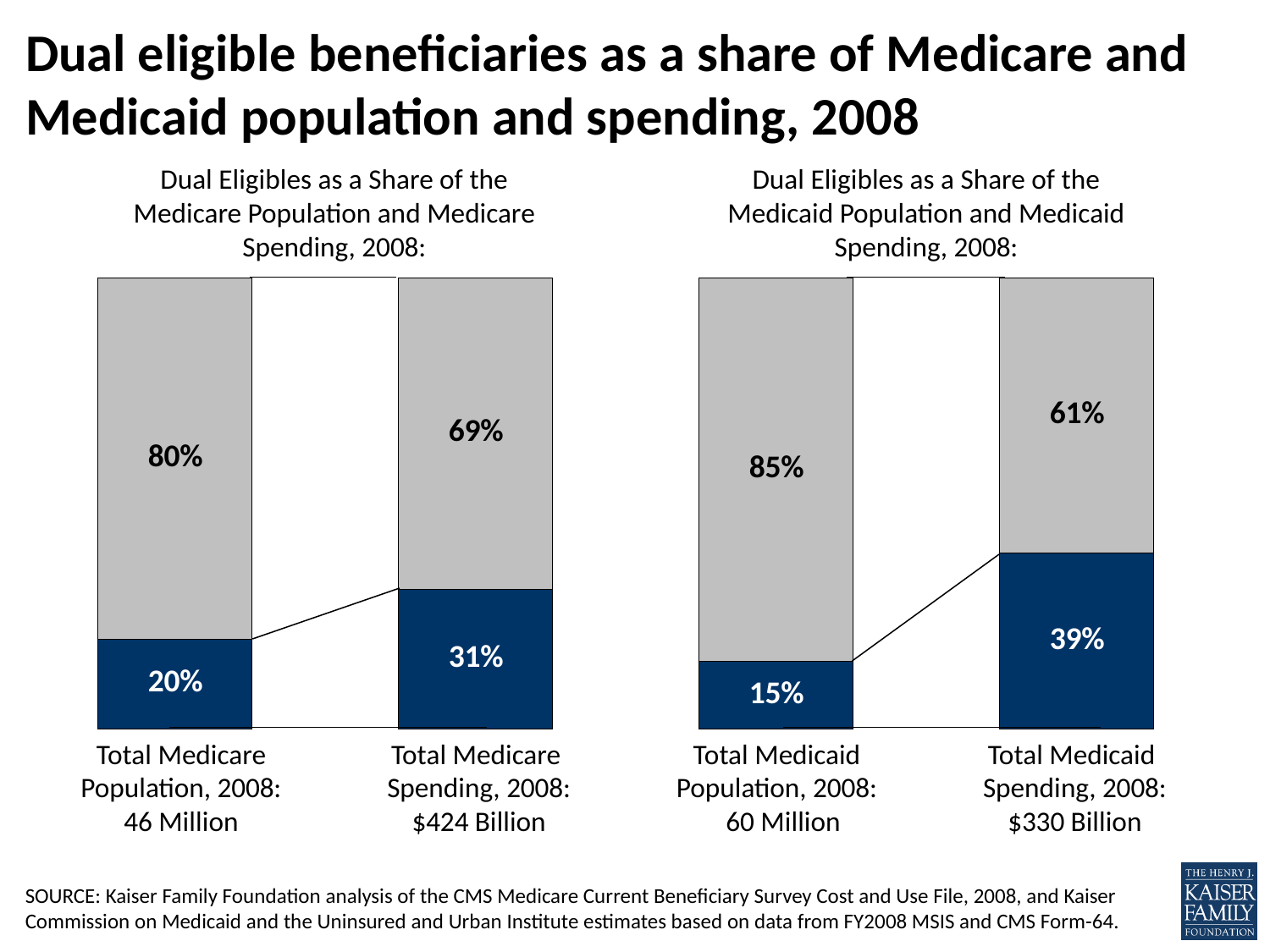
In the left chart (Medicare), what share of Total Medicare Spending, 2008 is shown in the dark blue segment? 31% In the right chart (Medicaid), what is the grey segment value for Total Medicaid Population, 2008? 85% In the right chart (Medicaid), what share of Total Medicaid Population, 2008 is shown in the dark blue segment? 15% In the left chart (Medicare), what is the difference between the dark blue share of spending (31%) and the dark blue share of population (20%)? 11 percentage points In the right chart (Medicaid), what is the difference between the dark blue share of spending (39%) and the dark blue share of population (15%)? 24 percentage points What type of chart is used on this slide? Stacked bar chart In the left chart (Medicare), what share of the total Medicare population is shown in the dark blue segment for Total Medicare Population, 2008? 20% In the right chart (Medicaid), what share of Total Medicaid Spending, 2008 is shown in the dark blue segment? 39% In the left chart (Medicare), what is the grey segment value for Total Medicare Spending, 2008? 69% What total Medicare spending amount is given in the x-axis label of the left chart for 2008? $424 Billion How many bars are shown in the left chart (Medicare)? 2 In the right chart (Medicaid), which bar has the larger dark blue segment: Total Medicaid Population, 2008 or Total Medicaid Spending, 2008? Total Medicaid Spending, 2008